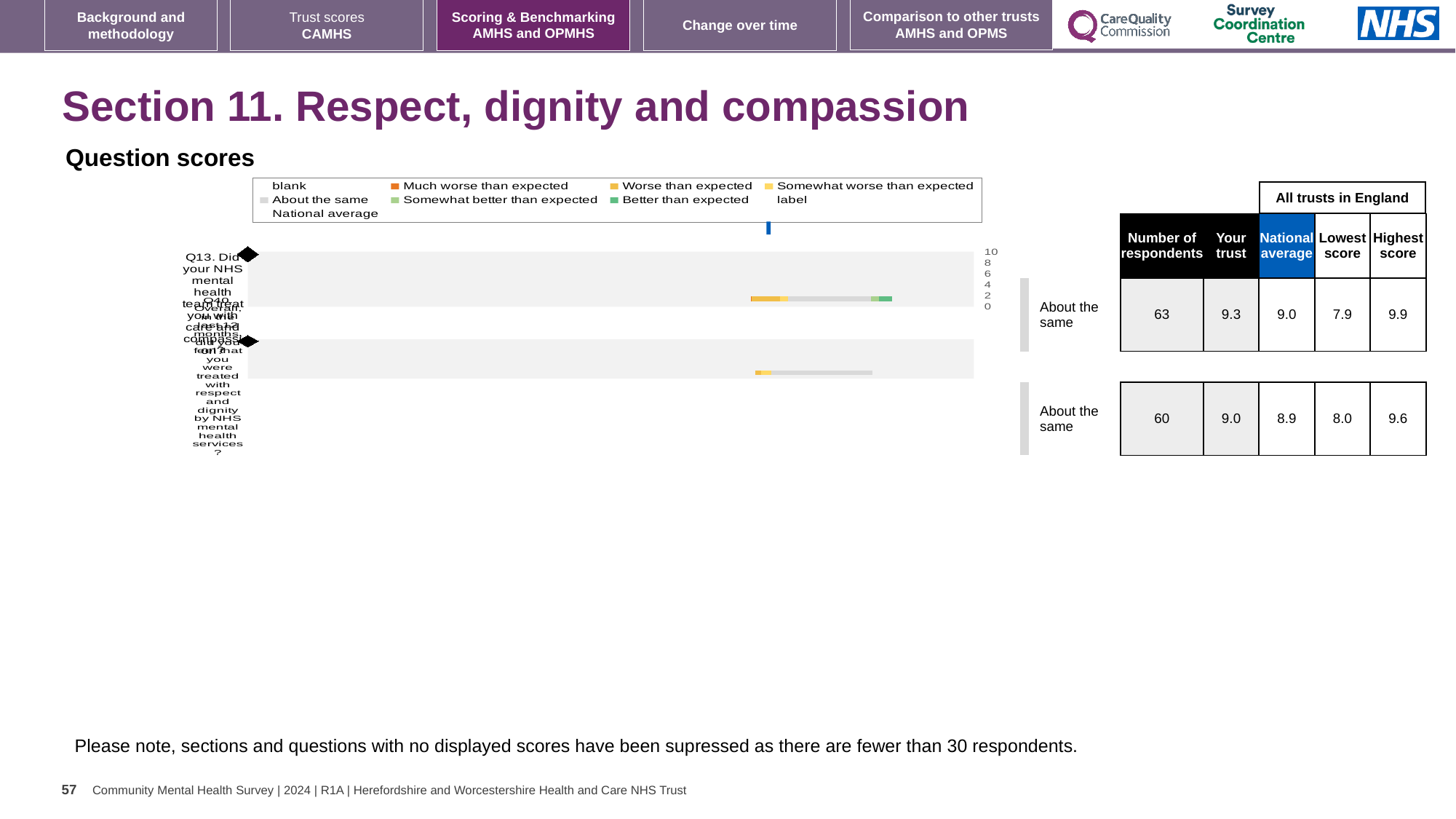
What kind of chart is shown under 'Question scores'? bar chart In the table next to the chart, what is the national average for the first (top) question? 9.0 In the table next to the chart, what is the number of respondents for the first (top) question? 63 What benchmark category label is shown beside each question's bar in the chart? About the same In the table next to the chart, what is the highest score among all trusts in England for the first (top) question? 9.9 What is the difference between the highest and lowest scores for the second (bottom) question? 1.6 In the table next to the chart, what is the number of respondents for the second (bottom) question? 60 In the table next to the chart, what is the lowest score among all trusts in England for the second (bottom) question? 8.0 What is the difference between the 'Your trust' score and the national average for the first (top) question? 0.3 How many questions (rows) are plotted in the 'Question scores' chart? 2 In the table next to the chart, what is the 'Your trust' score for the first (top) question? 9.3 Which question has more respondents, the first (top) or the second (bottom)? the first (top) question